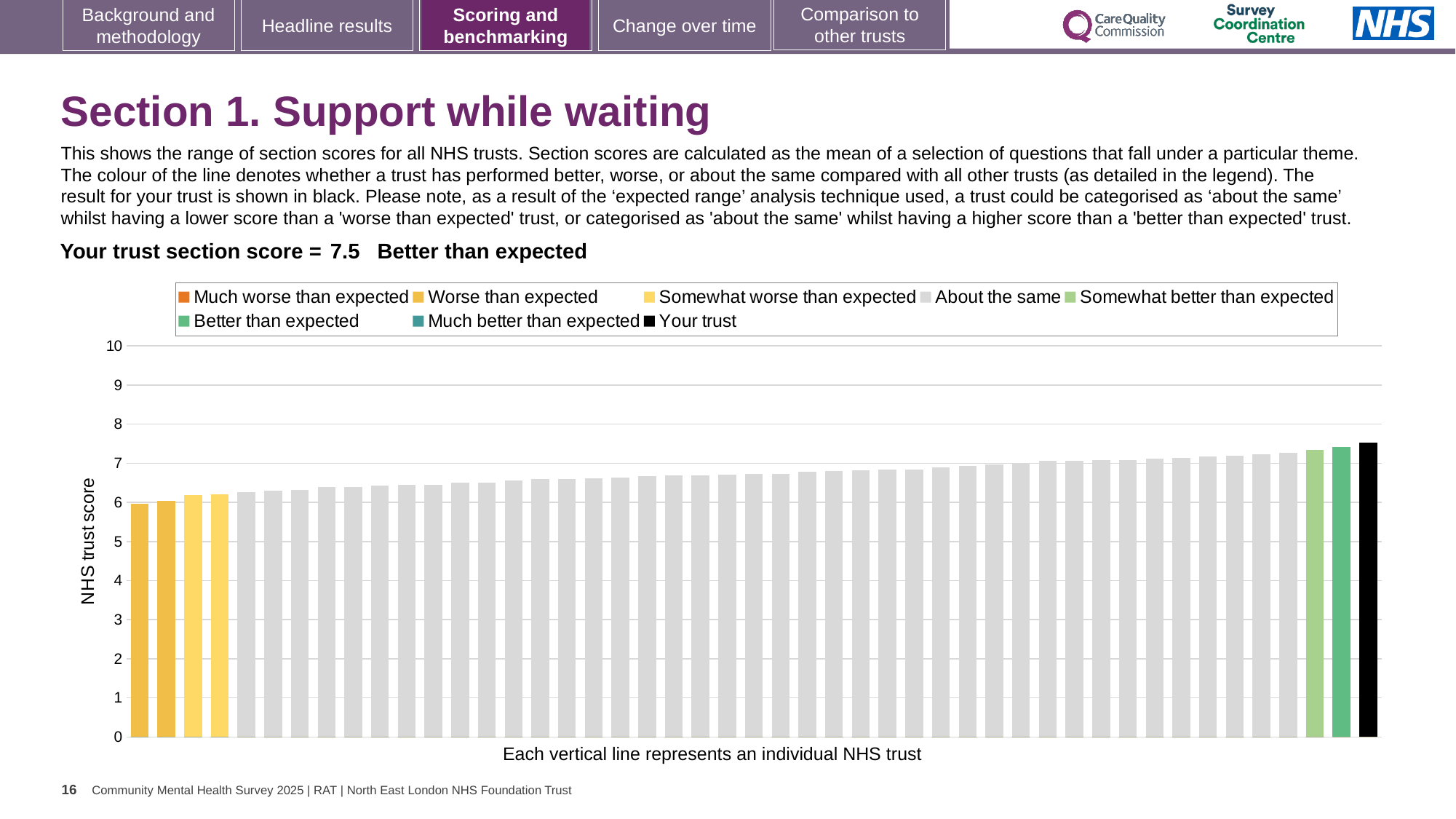
Is the value of the black bar (your trust) greater or less than 7? greater What is the title of the vertical axis? NHS trust score Is the value of the rightmost grey bar greater or less than 8? less How many bars in the chart are coloured black? 1 How many entries does the chart legend list? 8 What kind of chart is shown on the slide? bar chart Which category does your trust's section score fall into, according to the slide? Better than expected Which bar is the highest in the chart? the black bar (Your trust) What is the section score for your trust shown on the slide? 7.5 Is the value of the black bar (your trust) greater or less than 8? less Do the bar values rise or fall from left to right along the x axis? rise